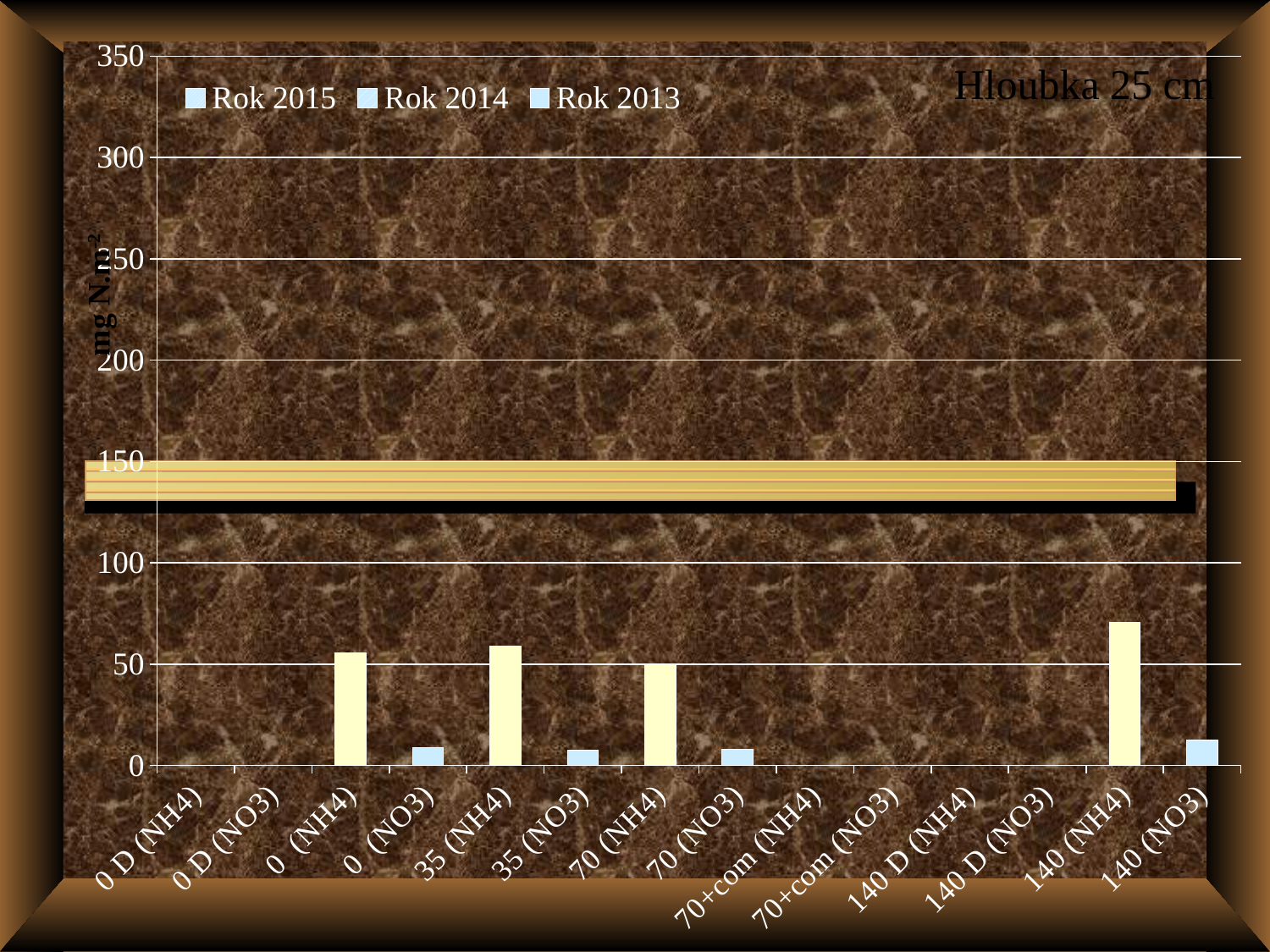
Which is larger, the bar for 140 (NH4) or the bar for 0 (NH4)? 140 (NH4) Which category has the tallest bar on the chart? 140 (NH4) How many categories are shown on the x axis? 14 Is the value for 140 (NH4) greater or less than 50? greater Which is larger, the bar for 35 (NH4) or the bar for 35 (NO3)? 35 (NH4) What kind of chart is shown on the slide? bar chart What are the series names listed in the legend? Rok 2015, Rok 2014, Rok 2013 How many series does the legend list? 3 Is the value for 0 (NH4) greater or less than 100? less What is the title shown in the top right corner of the chart? Hloubka 25 cm Is the value for 140 (NO3) greater or less than 50? less